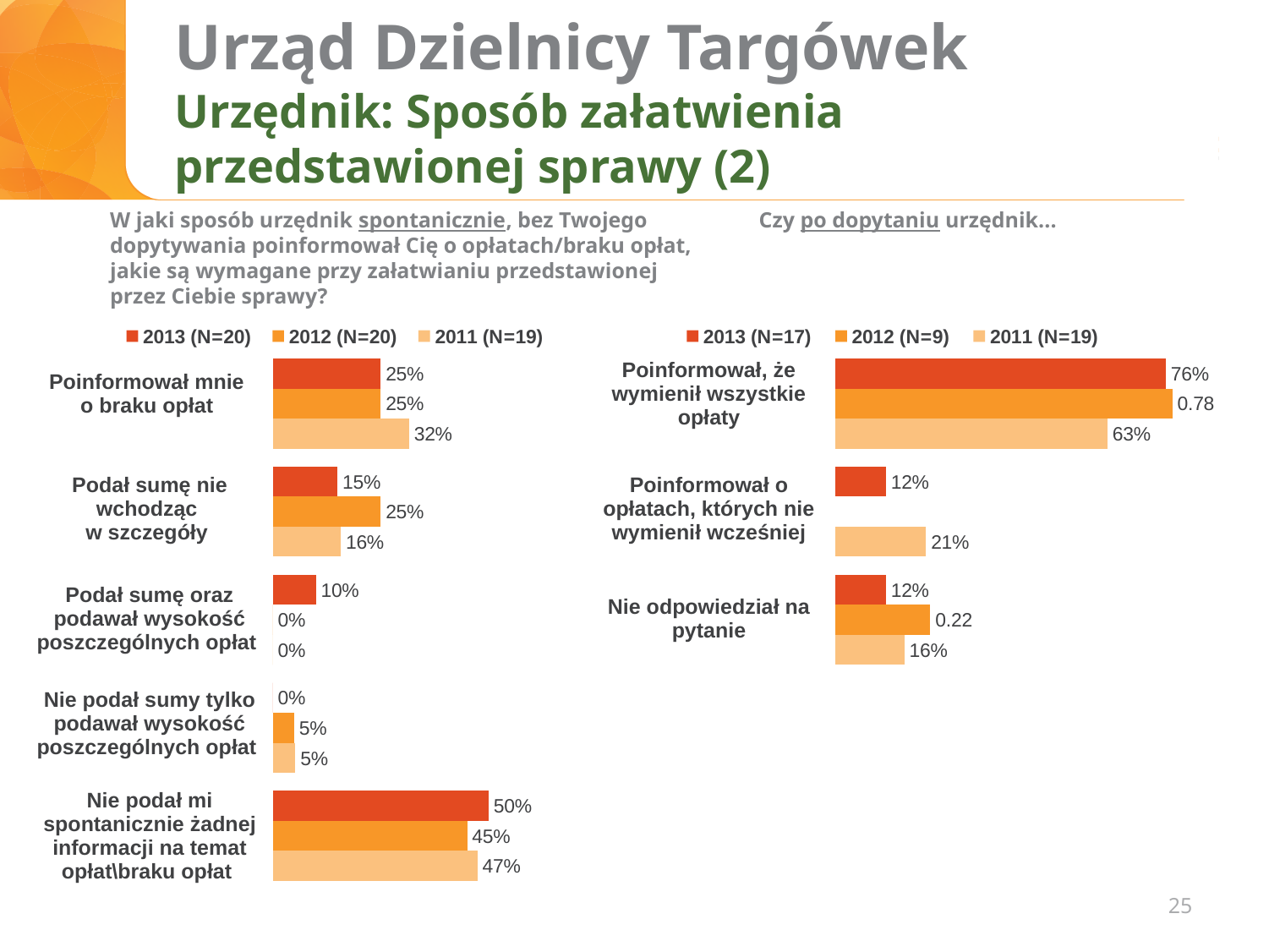
In the right chart, what is the 2013 (N=17) value for 'Poinformował, że wymienił wszystkie opłaty'? 76% In the left chart, which category has the highest 2013 (N=20) value? Nie podał mi spontanicznie żadnej informacji na temat opłat\braku opłat In the left chart, what is the 2011 (N=19) value for 'Poinformował mnie o braku opłat'? 32% In the right chart, what is the difference between the 2013 (N=17) and 2011 (N=19) values for 'Poinformował, że wymienił wszystkie opłaty'? 13% In the right chart, which is larger for 'Poinformował o opłatach, których nie wymienił wcześniej': the 2013 (N=17) value or the 2011 (N=19) value? 2011 (N=19) In the left chart, what is the difference between the 2012 (N=20) and 2013 (N=20) values for 'Podał sumę nie wchodząc w szczegóły'? 10% In the right chart, what sample size does the legend give for 2012? N=9 What type of chart is the right chart? Bar chart In the left chart, what is the 2013 (N=20) value for 'Nie podał mi spontanicznie żadnej informacji na temat opłat\braku opłat'? 50% In the left chart, how many series does the legend list? 3 In the left chart, how many categories are shown? 5 In the right chart, what is the 2012 (N=9) value for 'Nie odpowiedział na pytanie'? 0.22